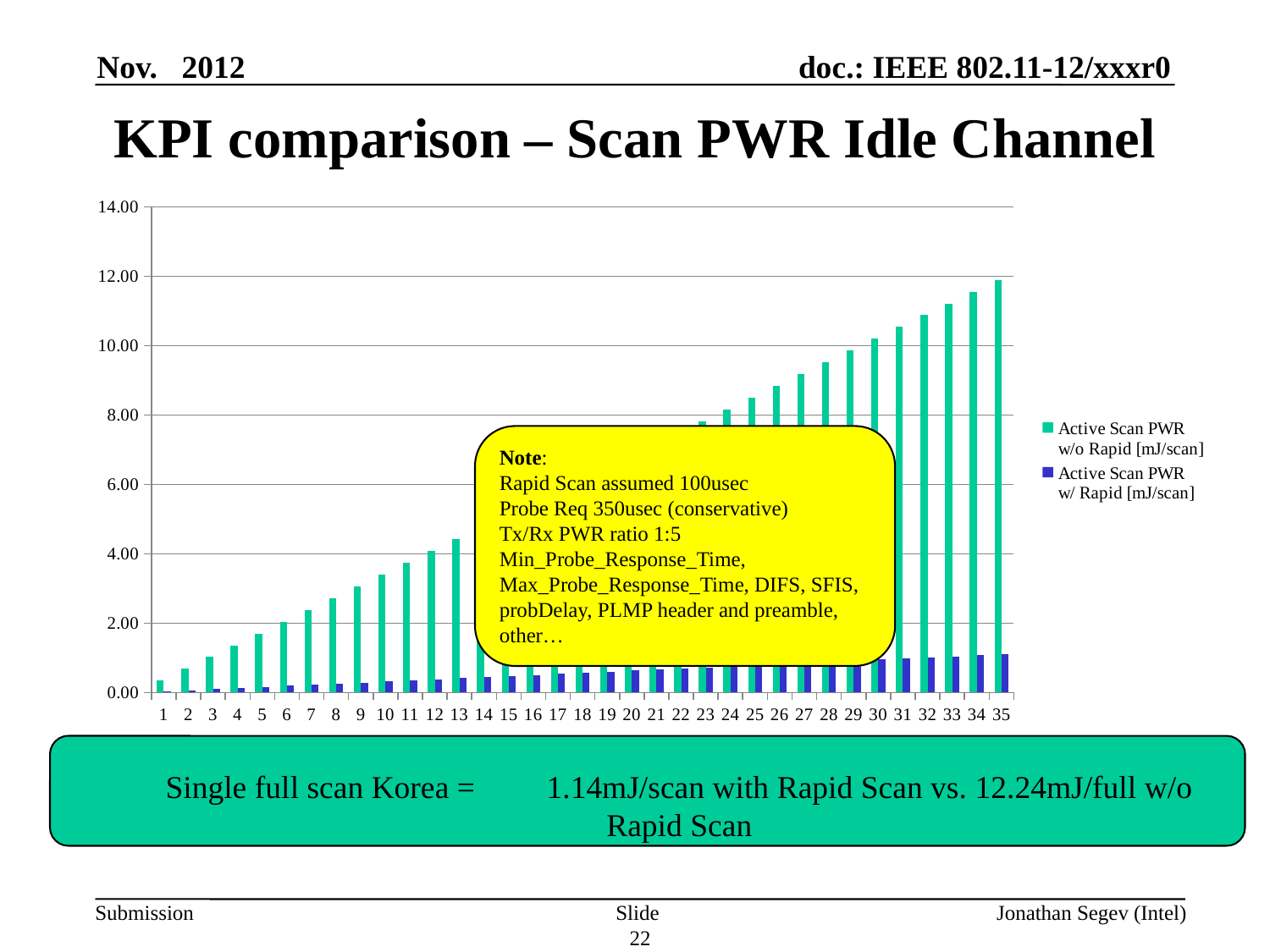
Is the value for Active Scan PWR w/ Rapid [mJ/scan] at category 35 greater or less than 2.00? less Which category has the lowest value for Active Scan PWR w/o Rapid [mJ/scan]? 1 What kind of chart is shown on the slide? bar chart How many series does the legend list? 2 At category 35, which series has the larger value: Active Scan PWR w/o Rapid [mJ/scan] or Active Scan PWR w/ Rapid [mJ/scan]? Active Scan PWR w/o Rapid [mJ/scan] How many categories are shown along the x axis? 35 Is the value for Active Scan PWR w/o Rapid [mJ/scan] at category 5 greater or less than 2.00? less Is the value for Active Scan PWR w/o Rapid [mJ/scan] at category 9 greater or less than 4.00? less What is the title of the slide containing the chart? KPI comparison – Scan PWR Idle Channel Do the values for Active Scan PWR w/o Rapid [mJ/scan] rise or fall as the x axis goes from 1 to 35? rise Which category has the highest value for Active Scan PWR w/o Rapid [mJ/scan]? 35